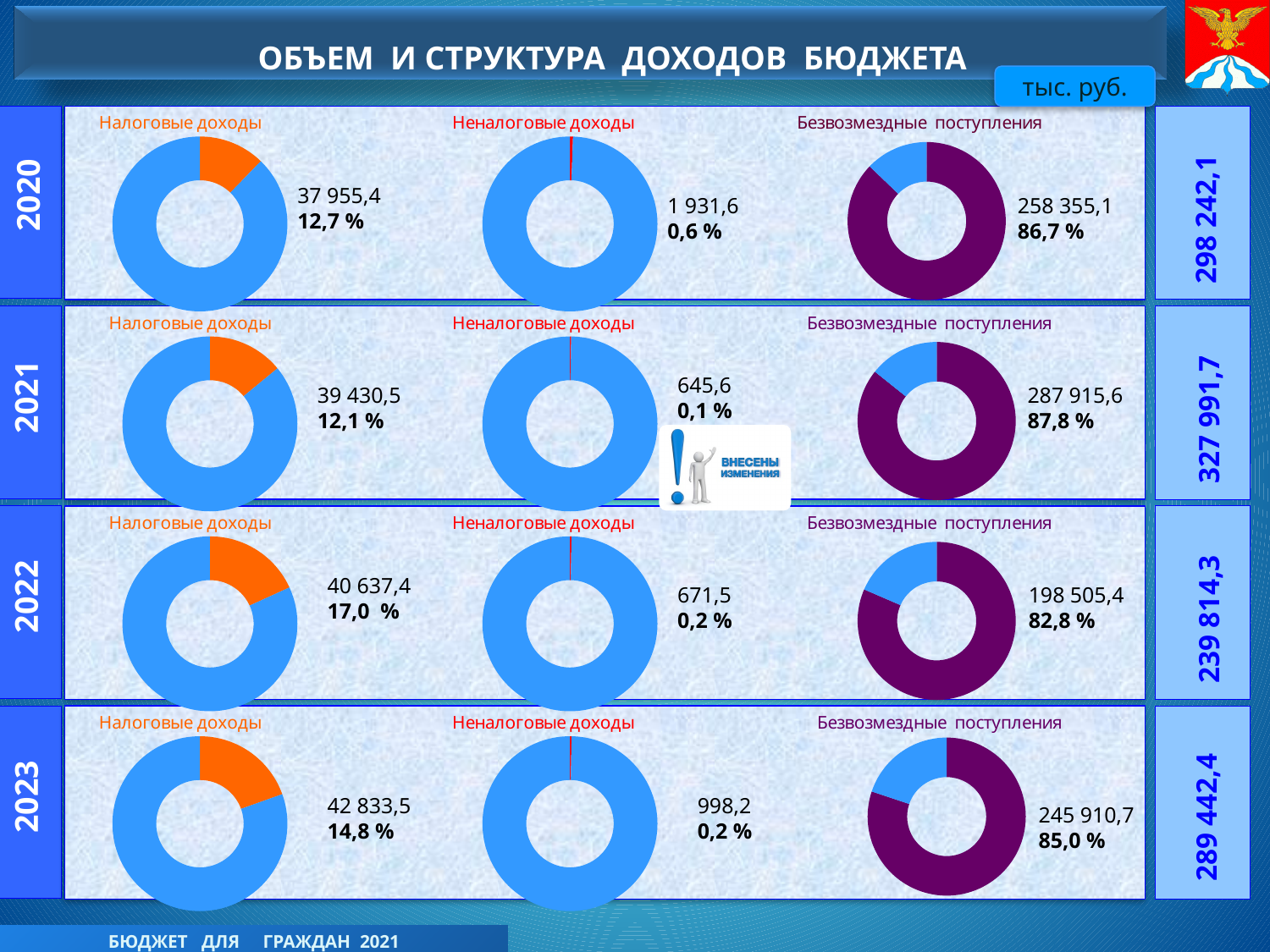
What kind of chart is used for each of the twelve charts on the slide? Donut (pie) chart What is the difference between the 'Налоговые доходы' values for 2021 and 2020? 1 475,1 Which year's 'Налоговые доходы' chart shows the highest percentage share? 2022 On the 2021 'Неналоговые доходы' chart, what value is printed? 645,6 On the 2020 'Налоговые доходы' chart, what value is printed next to the donut? 37 955,4 What total is printed on the right side of the slide for the year 2021? 327 991,7 On the 2023 'Безвозмездные поступления' chart, what value is printed? 245 910,7 How many donut charts are shown on the slide? 12 Which year's 'Неналоговые доходы' chart shows the lowest percentage share? 2021 Is the 'Налоговые доходы' value for 2023 larger or smaller than the 'Налоговые доходы' value for 2022? larger On the 2020 'Налоговые доходы' chart, what percentage share is shown? 12,7 % On the 2022 'Безвозмездные поступления' chart, what percentage share is shown? 82,8 %